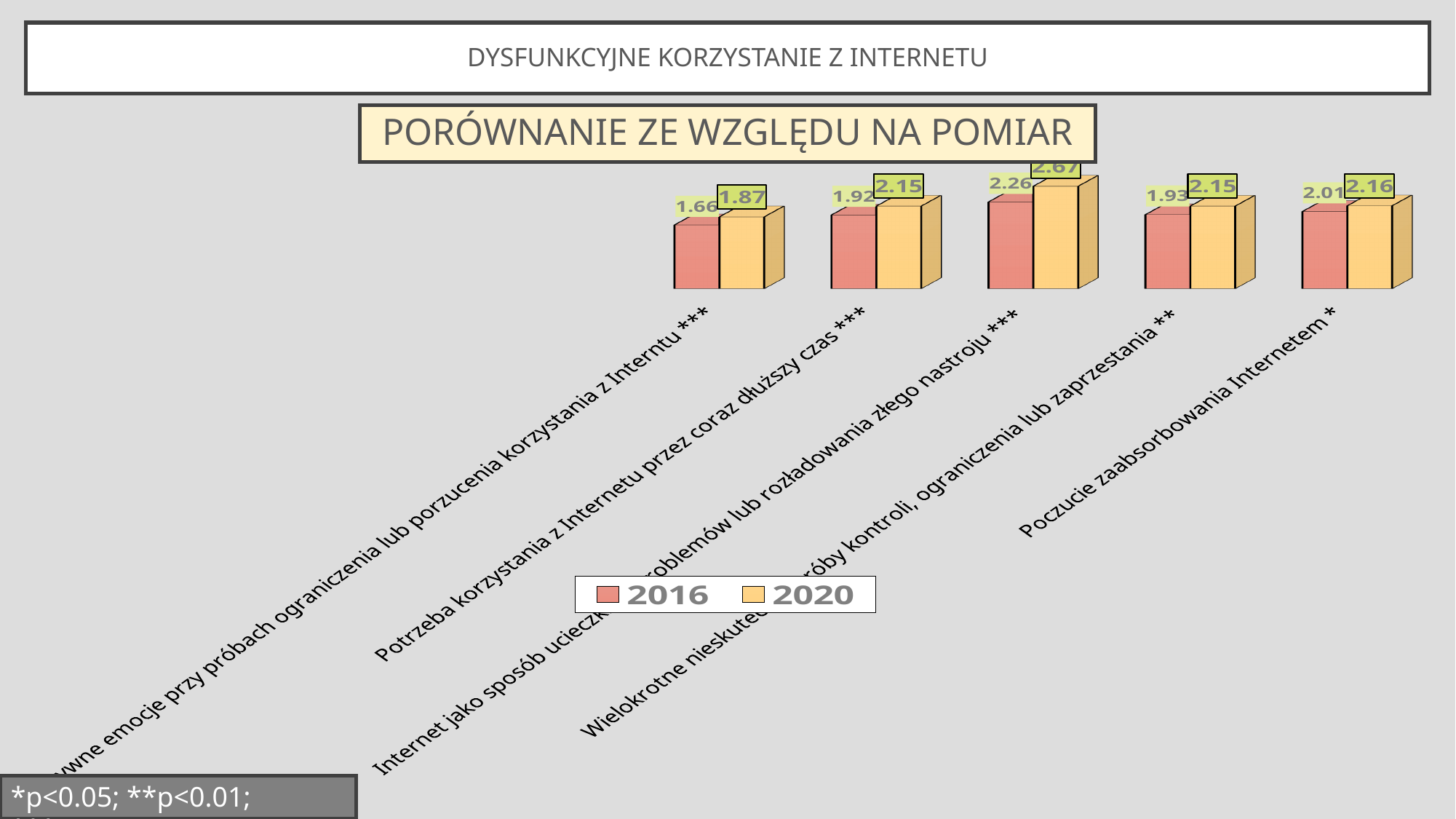
What is the 2020 value for 'Poczucie zaabsorbowania Internetem *'? 2.16 What type of chart is shown on the slide? bar chart What is the 2016 value for 'Poczucie zaabsorbowania Internetem *'? 2.01 How many categories are plotted in the chart? 5 What is the 2020 value for 'Wielokrotne nieskuteczne próby kontroli, ograniczenia lub zaprzestania **'? 2.15 How many series does the legend list? 2 What is the 2016 value for 'Potrzeba korzystania z Internetu przez coraz dłuższy czas ***'? 1.92 What is the difference between the 2020 and 2016 values for 'Potrzeba korzystania z Internetu przez coraz dłuższy czas ***'? 0.23 Which series is shown in orange in the legend? 2020 For 'Poczucie zaabsorbowania Internetem *', which series has the larger value, 2016 or 2020? 2020 Which category has the highest 2020 value? Internet jako sposób ucieczki od problemów lub rozładowania złego nastroju *** Across the categories, is the 2020 value always higher than the 2016 value? Yes